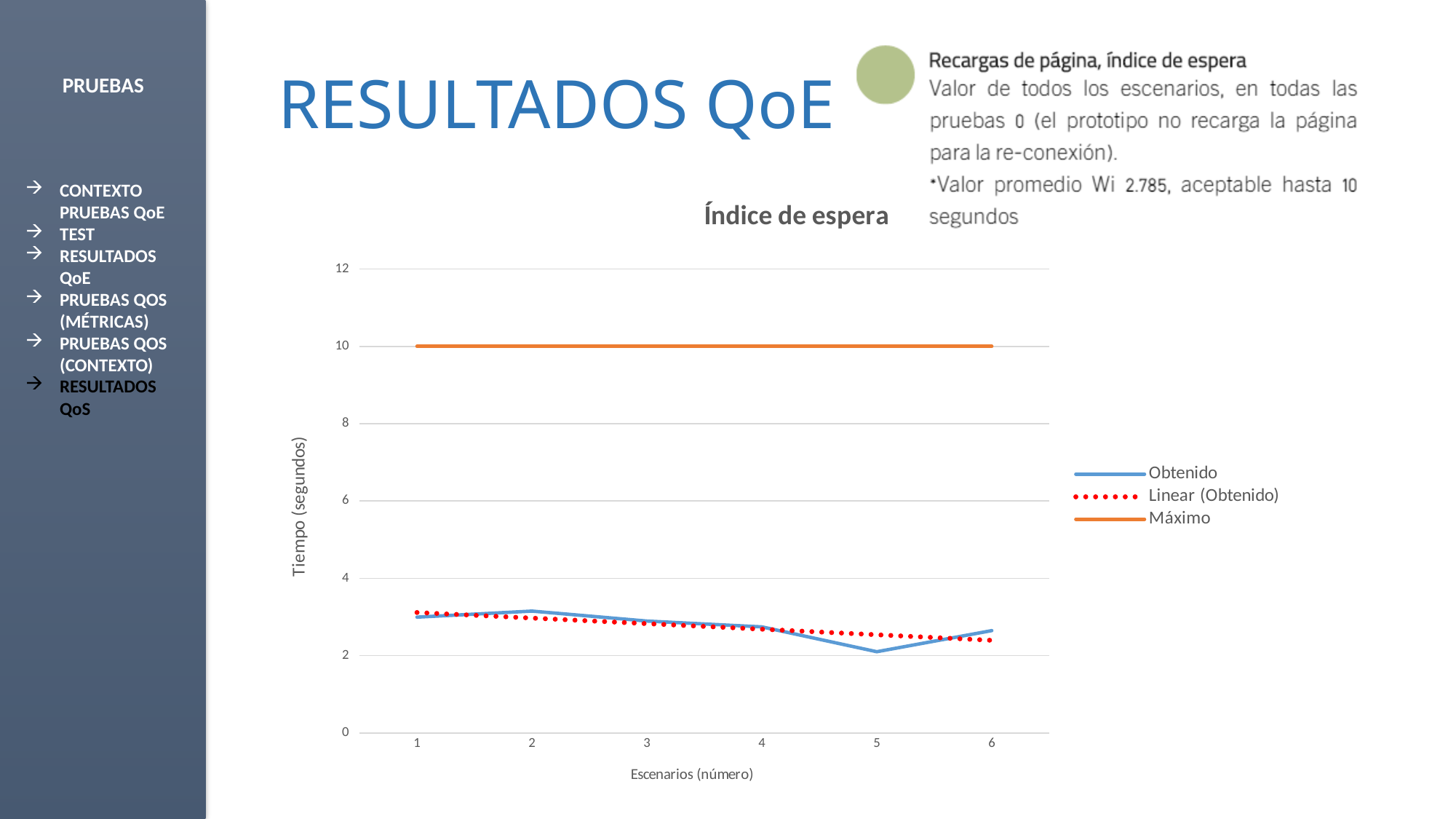
What is the label of the y axis of the chart? Tiempo (segundos) At scenario 3, which is larger: the Obtenido value or the Máximo value? Máximo Which scenario has the lowest Obtenido value? 5 What is the title of the chart? Índice de espera Is the Máximo value greater or less than 8? greater How many scenarios are plotted along the x axis of the "Índice de espera" chart? 6 What kind of chart is shown on the slide? line chart How many series does the legend of the "Índice de espera" chart list? 3 Is the Obtenido value for scenario 5 greater or less than 4? less What is the value of the Máximo series in the "Índice de espera" chart? 10 Is the Obtenido value for scenario 2 greater or less than 2? greater Does the Obtenido series rise or fall from scenario 2 to scenario 5? fall